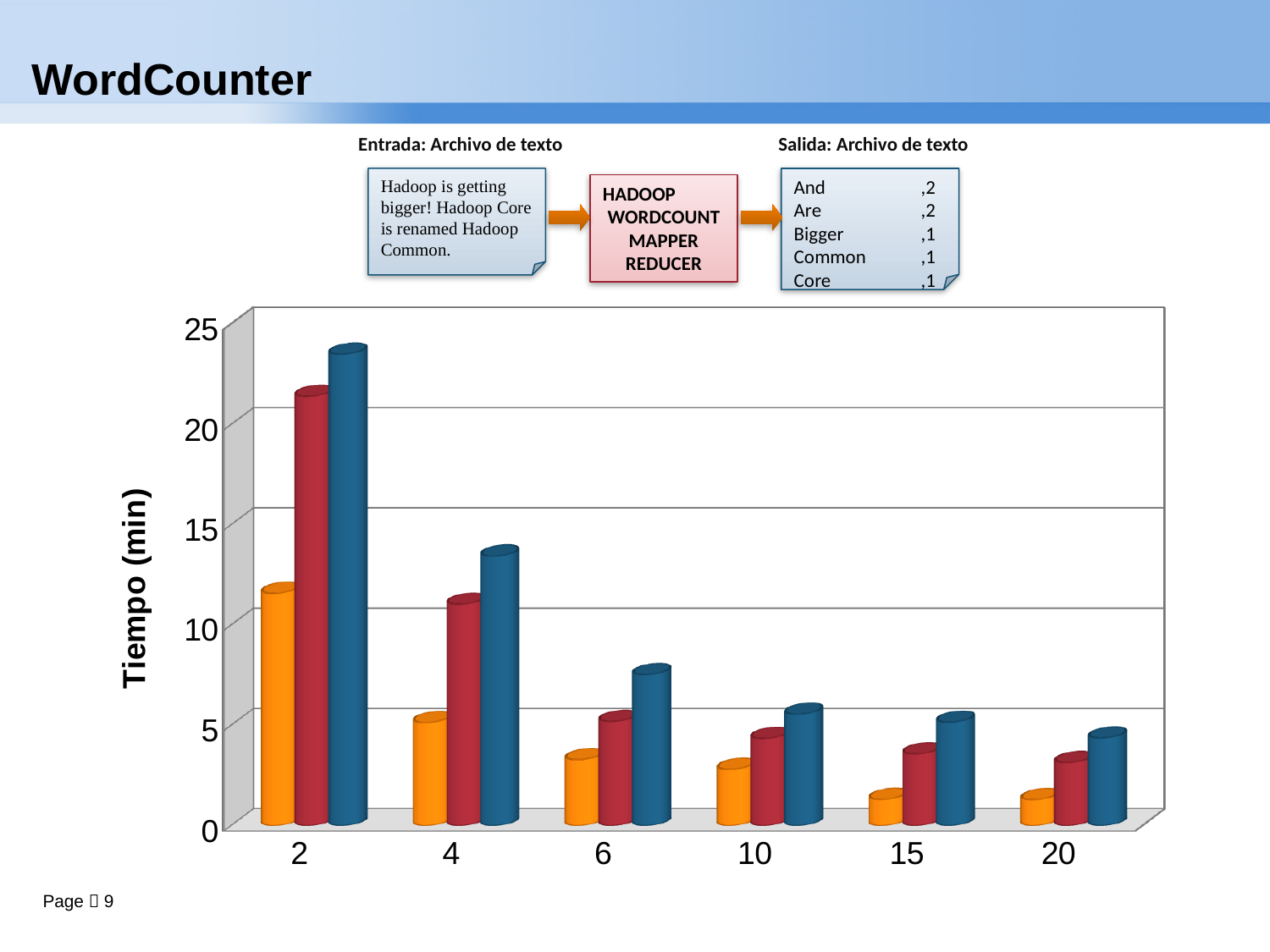
Which is larger: the blue bar at category 2 or the blue bar at category 4? the blue bar at category 2 Is the value of the blue bar at category 4 greater or less than 10? greater Which x-axis category has the tallest bar in the chart? 2 Is the value of the blue bar at category 2 greater or less than 20? greater Is the value of the orange bar at category 20 greater or less than 5? less How many categories are shown on the x axis of the chart? 6 How many bars are plotted for each x-axis category in the chart? 3 Do the bar heights generally rise or fall as the x-axis values increase from 2 to 20? fall What is the title of the vertical axis of the chart? Tiempo (min) What kind of chart is shown on the slide? bar chart